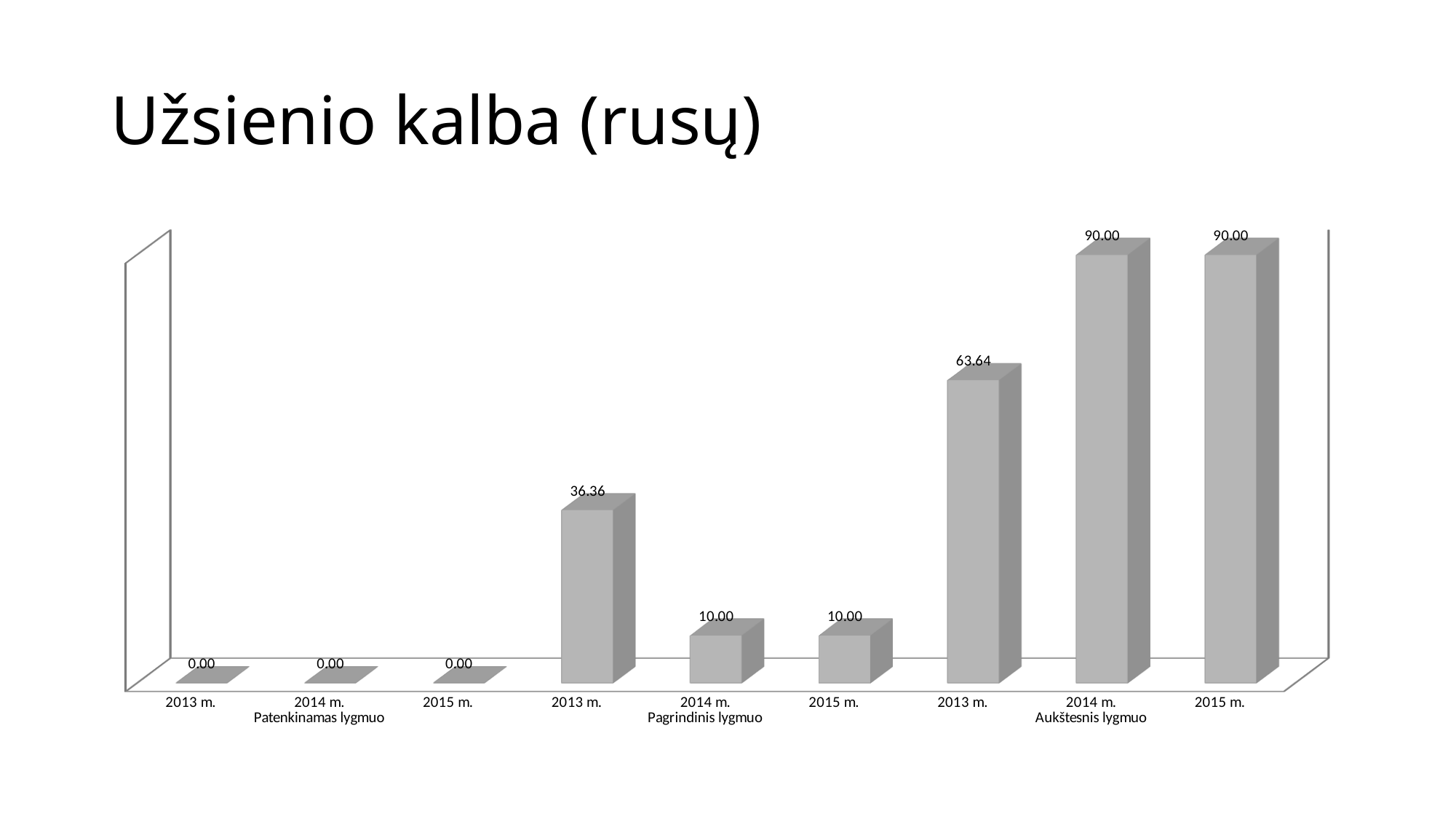
How many bars are plotted on the chart? 9 What is the value for 2014 m. in the Patenkinamas lygmuo group? 0.00 What is the value for 2013 m. in the Pagrindinis lygmuo group? 36.36 What is the value for 2015 m. in the Aukštesnis lygmuo group? 90.00 What is the difference between the 2014 m. and 2013 m. values in the Aukštesnis lygmuo group? 26.36 Which group has the lowest values overall? Patenkinamas lygmuo What is the difference between the 2013 m. and 2014 m. values in the Pagrindinis lygmuo group? 26.36 Which is larger: the 2013 m. value in the Pagrindinis lygmuo group or the 2013 m. value in the Aukštesnis lygmuo group? Aukštesnis lygmuo 2013 m. What is the value for 2013 m. in the Aukštesnis lygmuo group? 63.64 What is the value for 2014 m. in the Pagrindinis lygmuo group? 10.00 What kind of chart is shown on the slide? Bar chart Which group has the highest values overall? Aukštesnis lygmuo